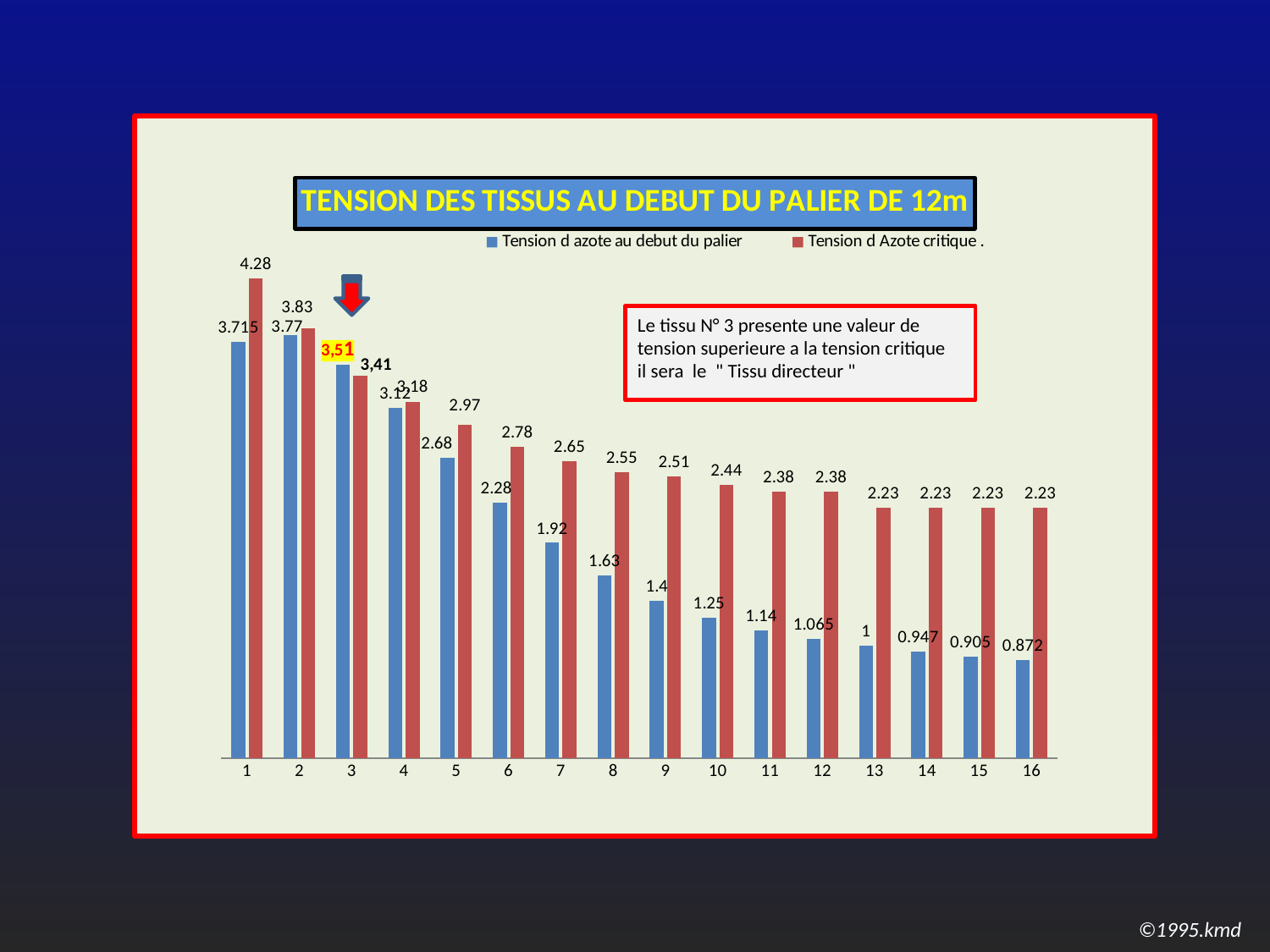
What type of chart is shown on the slide? bar chart How many categories are shown on the x axis? 16 Which category has the highest value for 'Tension d Azote critique'? 1 What is the difference between 'Tension d Azote critique' and 'Tension d azote au debut du palier' for category 8? 0.92 Do the values of 'Tension d Azote critique' rise or fall from category 1 to category 16? fall How many series does the legend list? 2 Which category has the lowest value for 'Tension d azote au debut du palier'? 16 What is the value of 'Tension d Azote critique' for category 13? 2.23 What is the value of 'Tension d azote au debut du palier' for category 1? 3.715 For category 3, which is larger: 'Tension d azote au debut du palier' or 'Tension d Azote critique'? Tension d azote au debut du palier What is the value of 'Tension d Azote critique' for category 1? 4.28 What is the value of 'Tension d azote au debut du palier' for category 16? 0.872